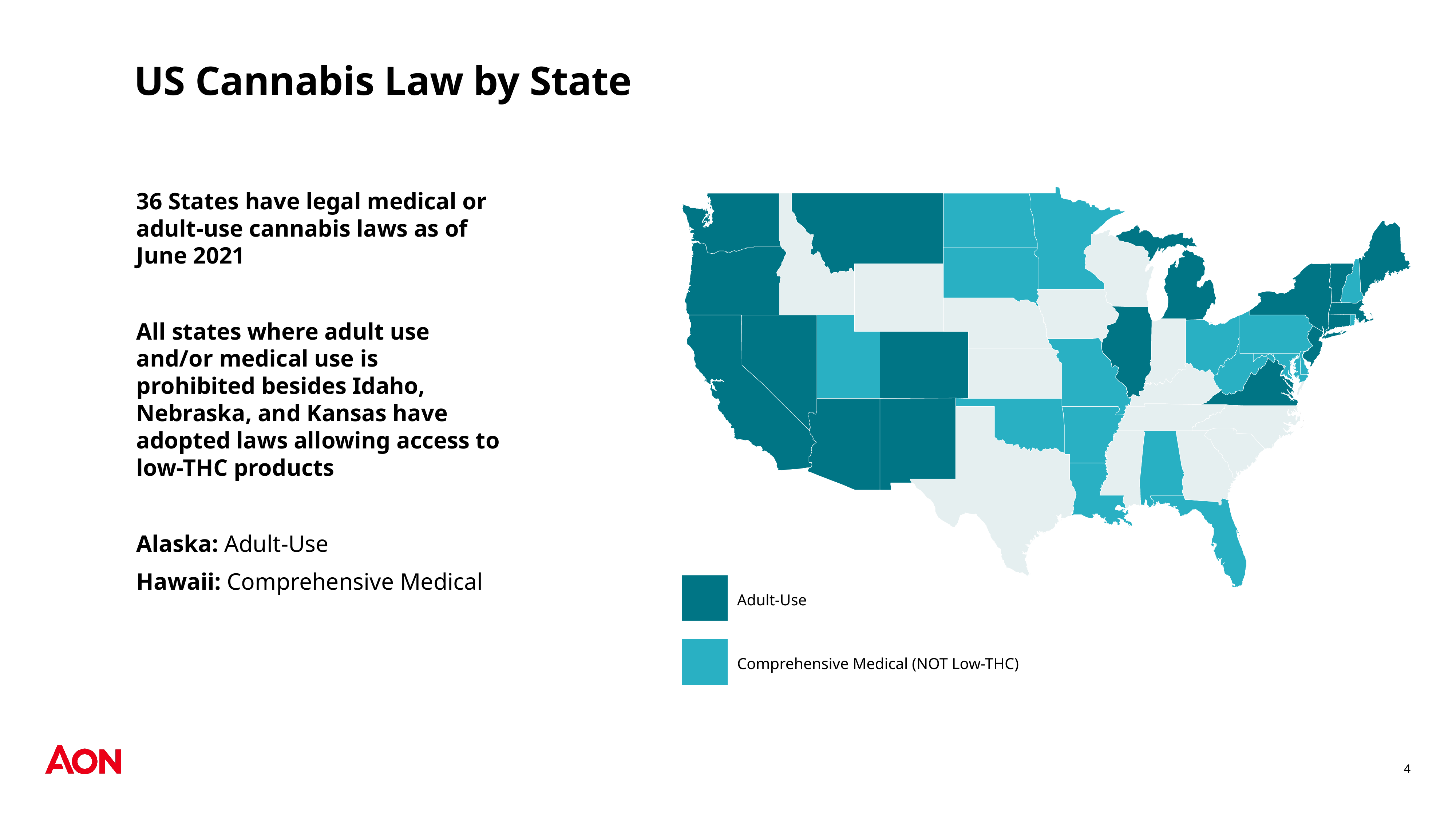
How many categories does the map's legend list? 2 What kind of chart is shown on the slide? Map Which legend category is shown in the darker teal colour? Adult-Use According to the slide, what is Alaska's cannabis law status? Adult-Use What are the two categories listed in the map's legend? Adult-Use; Comprehensive Medical (NOT Low-THC) According to the slide, what is Hawaii's cannabis law status? Comprehensive Medical According to the slide, how many states have legal medical or adult-use cannabis laws as of June 2021? 36